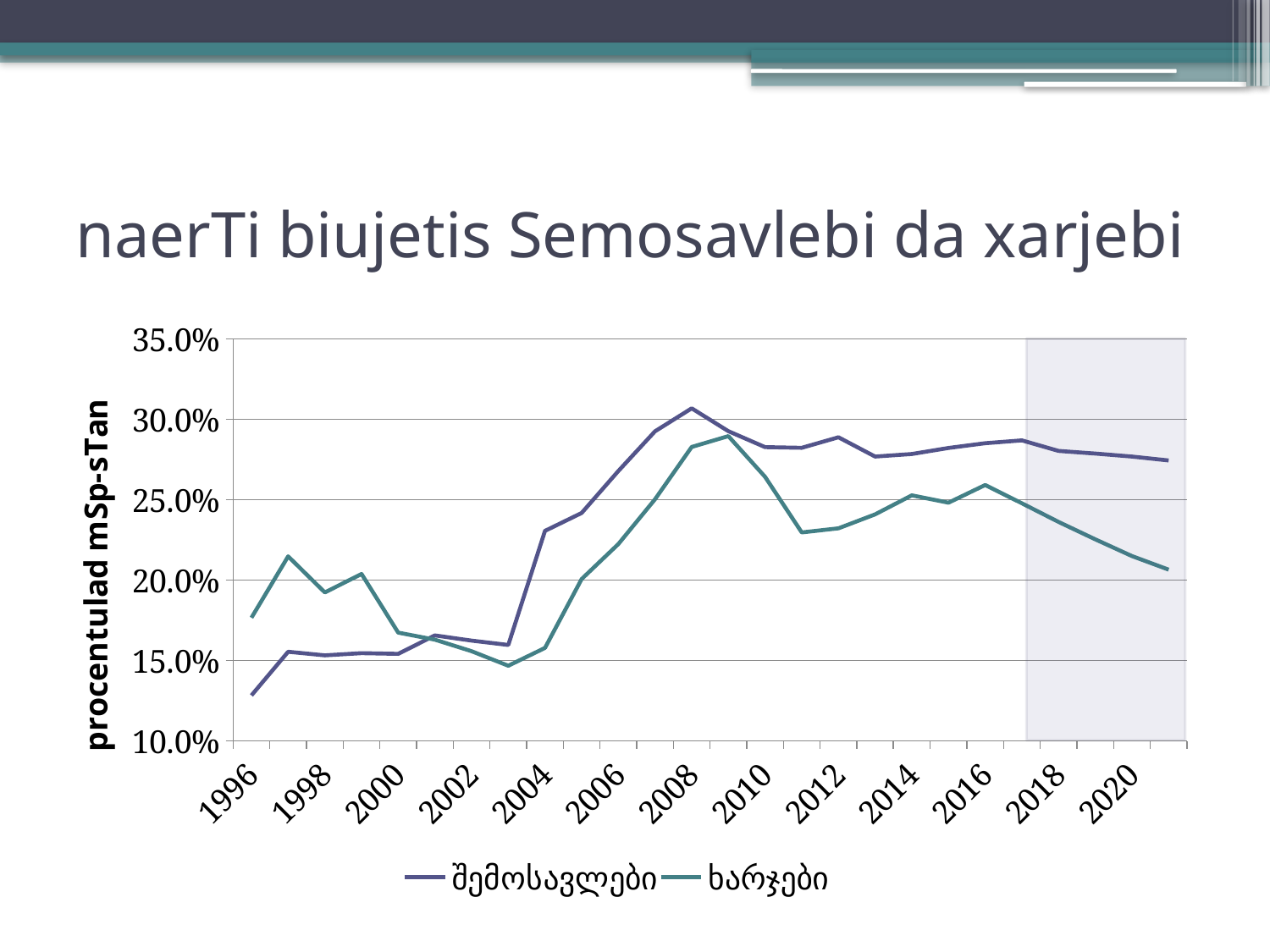
Does the შემოსავლები series rise or fall between 2017 and 2021? fall What kind of chart is shown on the slide? line chart In which year is the შემოსავლები series at its lowest value? 1996 Is the value for შემოსავლები in 1996 greater or less than 15.0%? less How many series does the legend list? 2 What is the title of the chart on the slide? naerTi biujetis Semosavlebi da xarjebi Is the value for ხარჯები in 2011 greater or less than 25.0%? less In which year does the შემოსავლები series reach its highest value? 2008 Is the value for შემოსავლები in 2008 greater or less than 25.0%? greater In 1997, which series has the higher value, შემოსავლები or ხარჯები? ხარჯები What is the label on the vertical axis? procentulad mSp-sTan In which year is the ხარჯები series at its lowest value? 2003